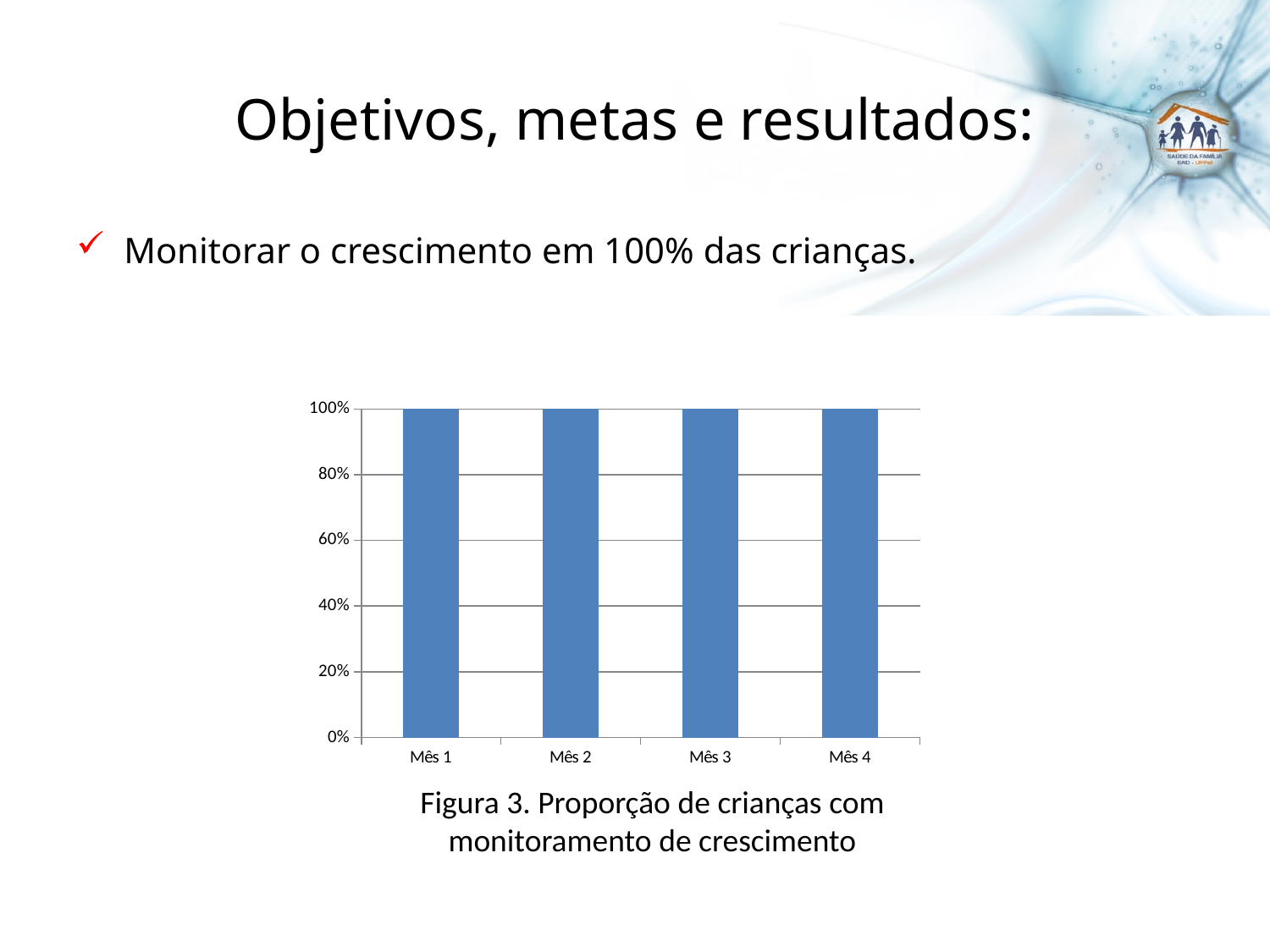
What is the caption (figure title) given below the chart? Figura 3. Proporção de crianças com monitoramento de crescimento How many categories (months) are shown on the x axis of the chart? 4 Do the values rise, fall, or stay the same from Mês 1 to Mês 4? stay the same What is the value for Mês 1 in the chart? 100% Is the value for Mês 4 greater or less than 60%? greater What is the value for Mês 3 in the chart? 100% What is the difference between the values for Mês 1 and Mês 4? 0% What is the value for Mês 4 in the chart? 100% What is the highest value shown on the y axis of the chart? 100% Is the value for Mês 2 greater or less than 80%? greater What type of chart is shown on the slide? bar chart